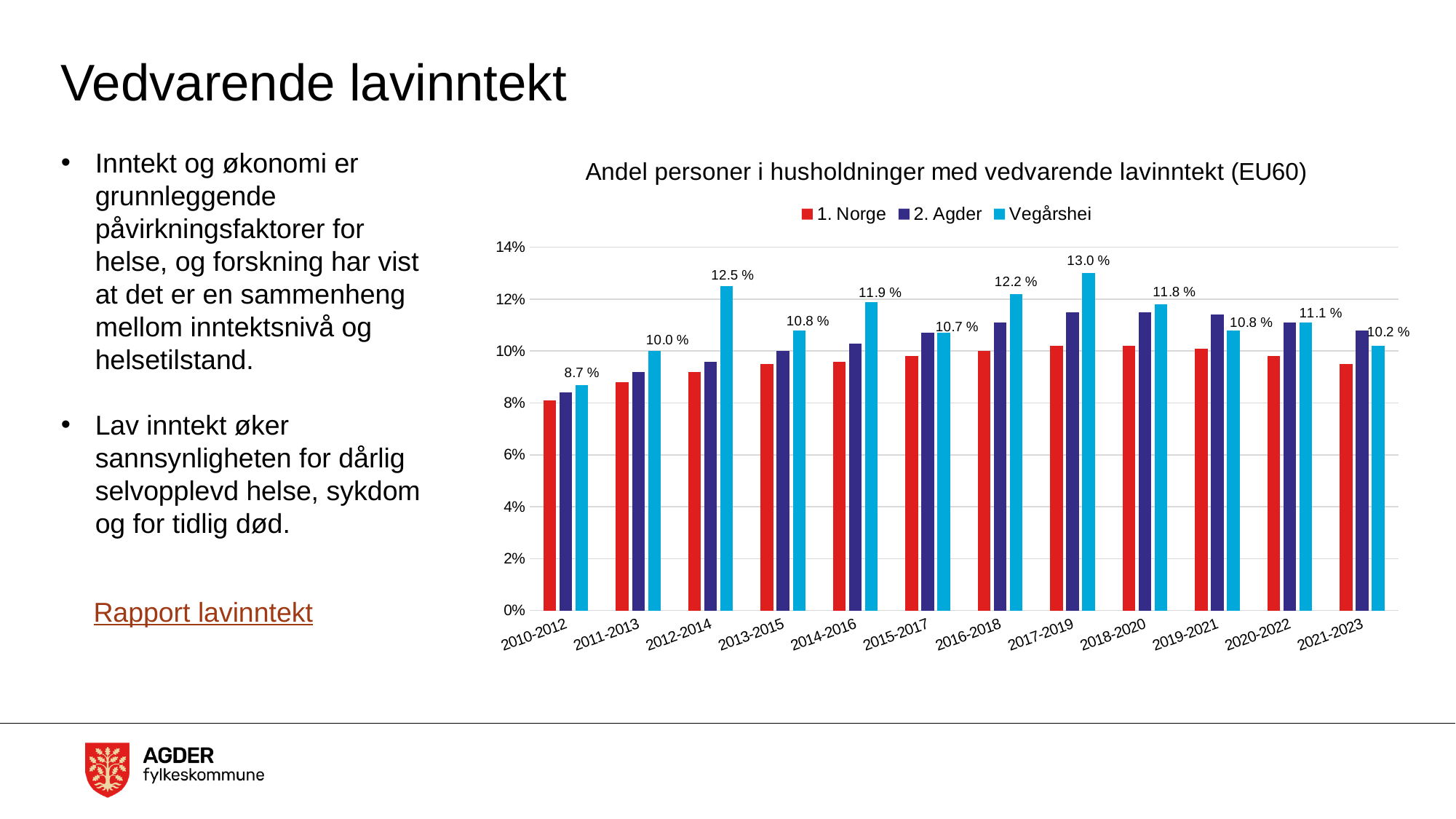
In which period is the Vegårshei value highest? 2017-2019 Is the value for 1. Norge in 2013-2015 greater or less than 10%? less In which period is the Vegårshei value lowest? 2010-2012 Which is larger, the Vegårshei value for 2012-2014 or for 2013-2015? 2012-2014 What is the difference between the Vegårshei values for 2017-2019 and 2010-2012? 4.3 percentage points What kind of chart is shown on the slide? Bar chart Is the value for 2. Agder in 2017-2019 greater or less than 10%? greater What is the value for Vegårshei in 2021-2023? 10.2 % How many periods are shown on the x axis? 12 How many series does the legend list? 3 What is the value for Vegårshei in 2017-2019? 13.0 % What is the value for Vegårshei in 2012-2014? 12.5 %